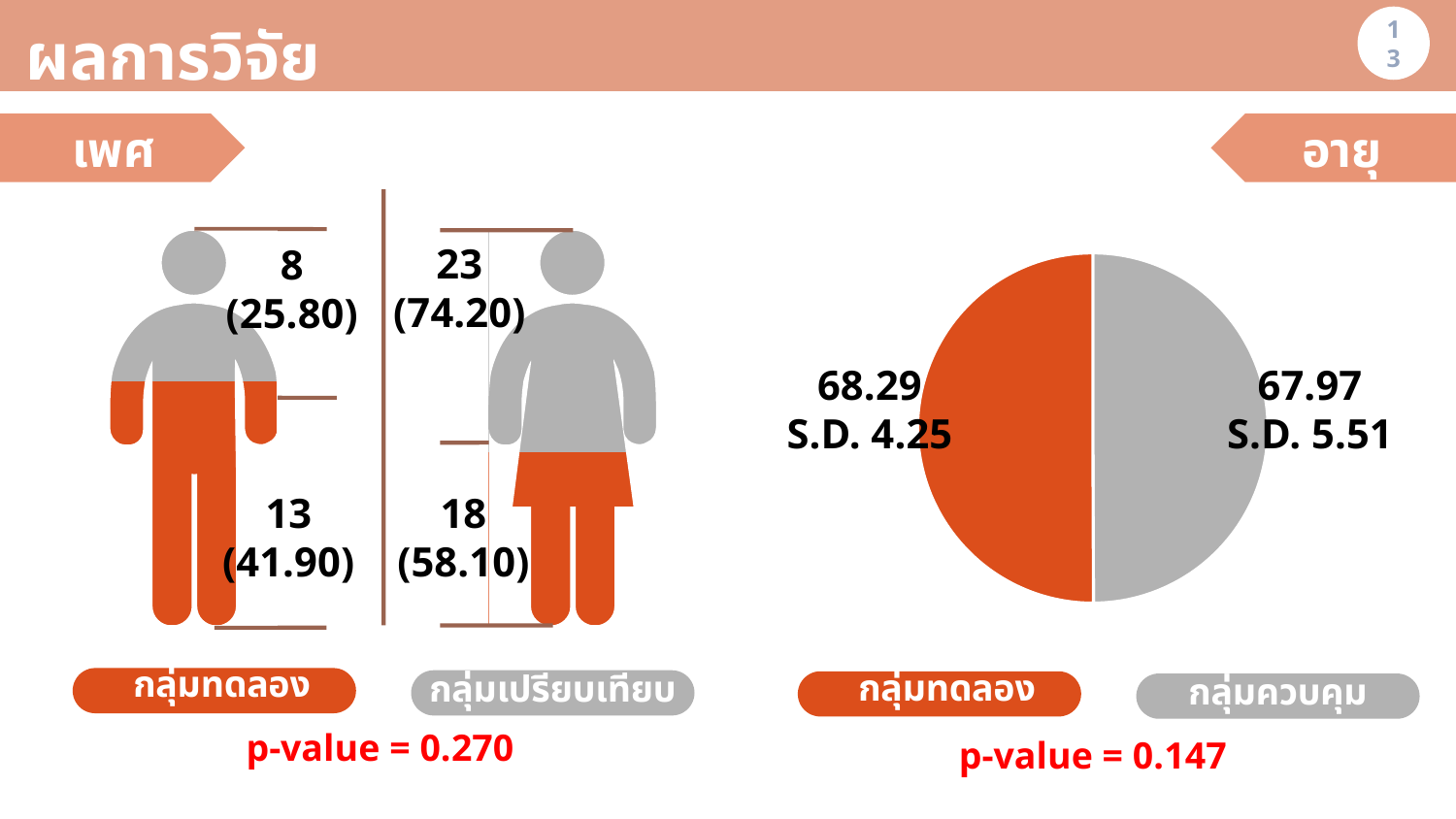
On the "เพศ" figure chart, what value and percentage are shown for the orange กลุ่มทดลอง portion of the female figure? 18 (58.10) What p-value is printed under the "เพศ" chart? p-value = 0.270 On the "เพศ" figure chart, what value and percentage are shown for the grey กลุ่มเปรียบเทียบ portion of the female figure? 23 (74.20) On the pie chart under "อายุ", which group has the larger mean value, กลุ่มทดลอง or กลุ่มควบคุม? กลุ่มทดลอง On the pie chart under "อายุ", what S.D. is shown for กลุ่มทดลอง? S.D. 4.25 What kind of chart is shown under "อายุ"? pie chart On the pie chart under "อายุ", what mean value is shown for the grey กลุ่มควบคุม slice? 67.97 On the pie chart under "อายุ", what mean value is shown for the orange กลุ่มทดลอง slice? 68.29 On the pie chart under "อายุ", what S.D. is shown for กลุ่มควบคุม? S.D. 5.51 On the pie chart under "อายุ", what is the difference between the two mean values shown? 0.32 How many groups does the legend under the "อายุ" pie chart list? 2 On the "เพศ" figure chart, what value and percentage are shown for the orange กลุ่มทดลอง portion of the male figure? 13 (41.90)